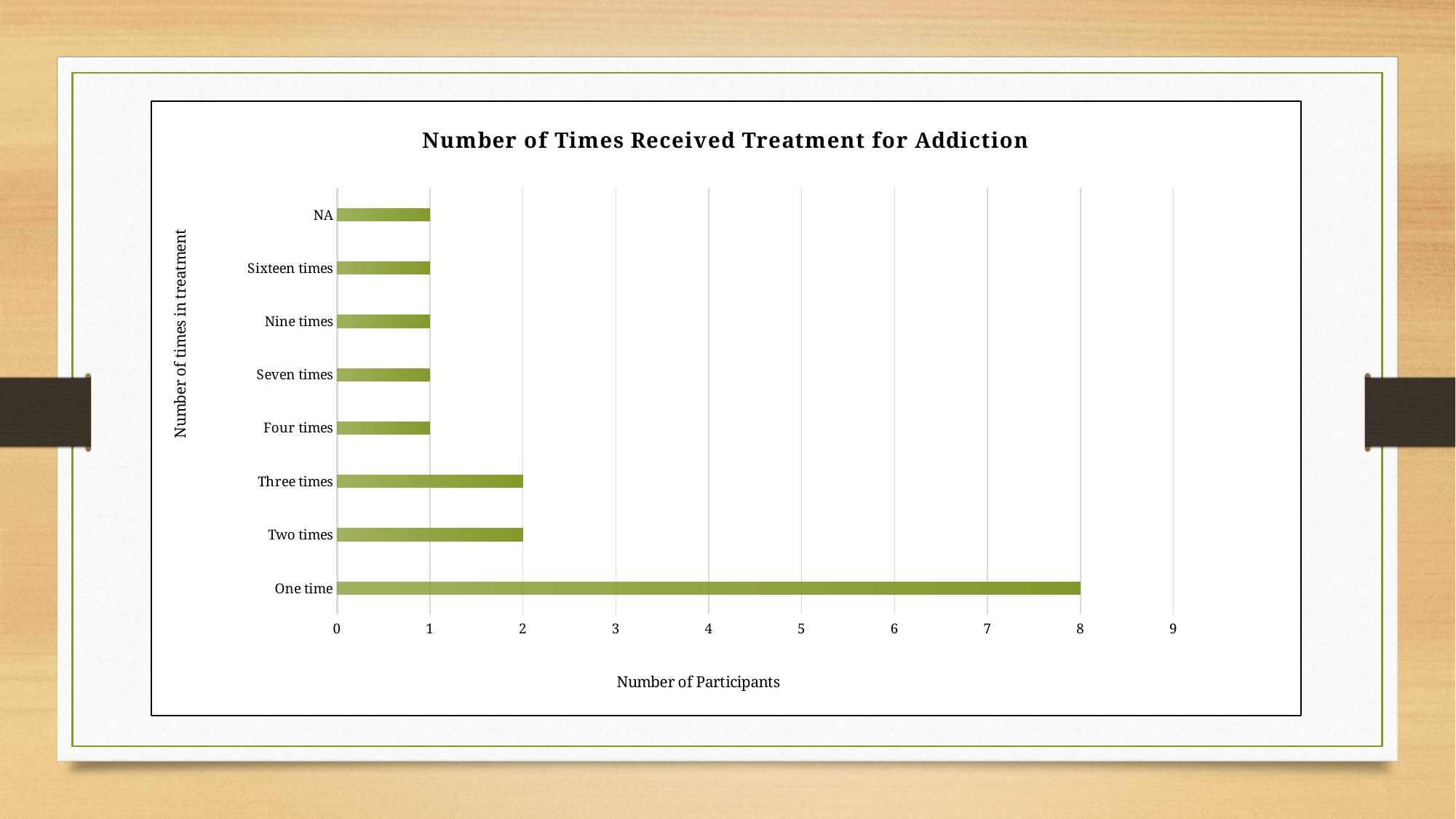
How many participants received treatment one time? 8 How many participants received treatment sixteen times? 1 Is the value for One time greater or less than 5? greater Which has more participants, One time or Three times? One time How many participants received treatment three times? 2 What is the label of the horizontal axis? Number of Participants What is the difference in number of participants between One time and Two times? 6 What type of chart is shown on the slide? bar chart How many categories are shown on the chart? 8 What is the title of the chart? Number of Times Received Treatment for Addiction How many participants received treatment two times? 2 Which category has the highest number of participants? One time